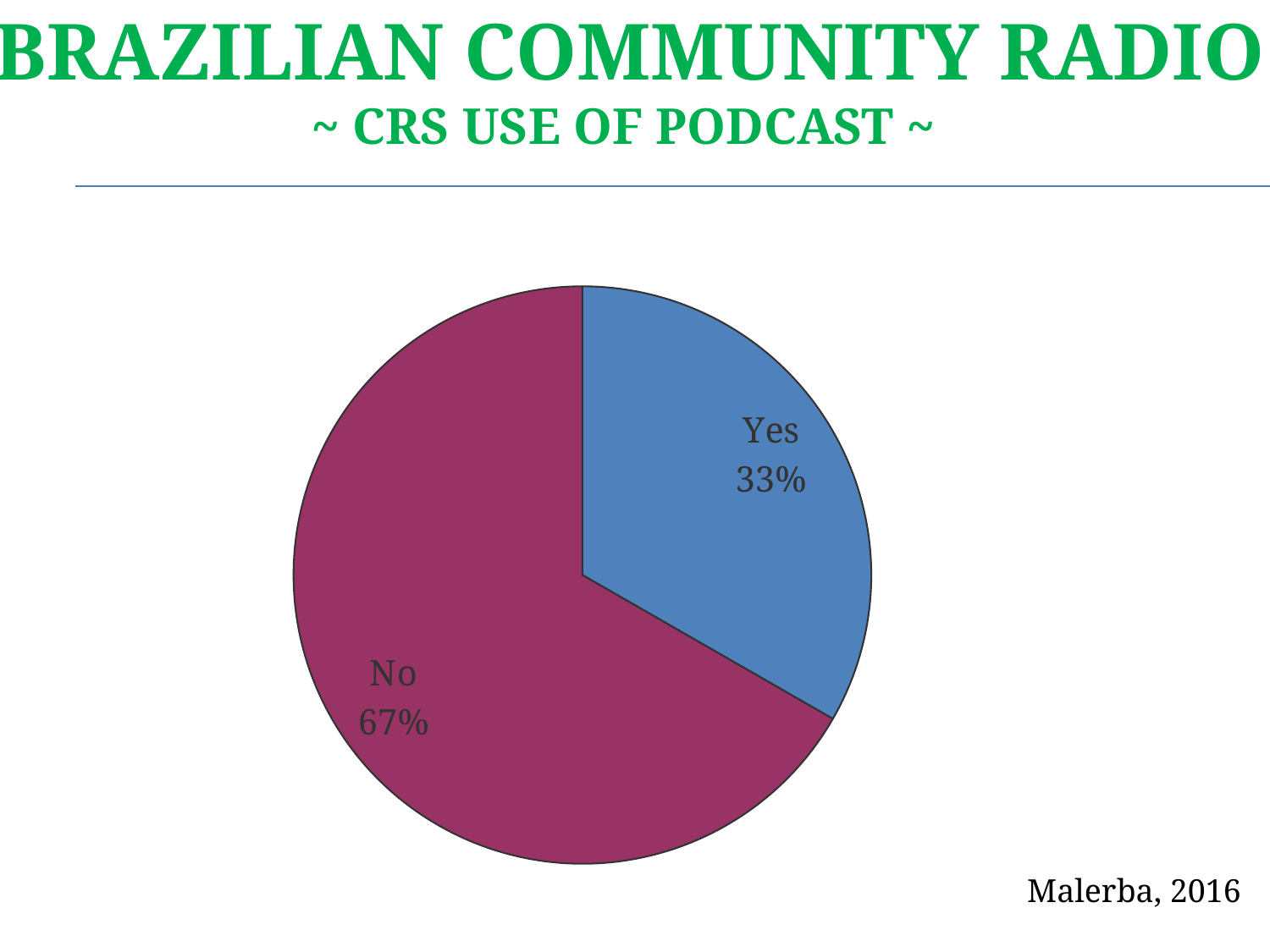
Which slice is the largest in the pie chart? No Which is larger, the "Yes" slice or the "No" slice? No What colour is the "Yes" slice? blue What share of the pie does the "No" slice represent? 67% How many slices does the pie chart have? 2 What is the subtitle of the slide describing the chart? ~ CRS USE OF PODCAST ~ What is the difference in percentage points between the "No" and "Yes" slices? 34 What kind of chart is shown on the slide? pie chart Which slice is the smallest in the pie chart? Yes What share of the pie does the "Yes" slice represent? 33%